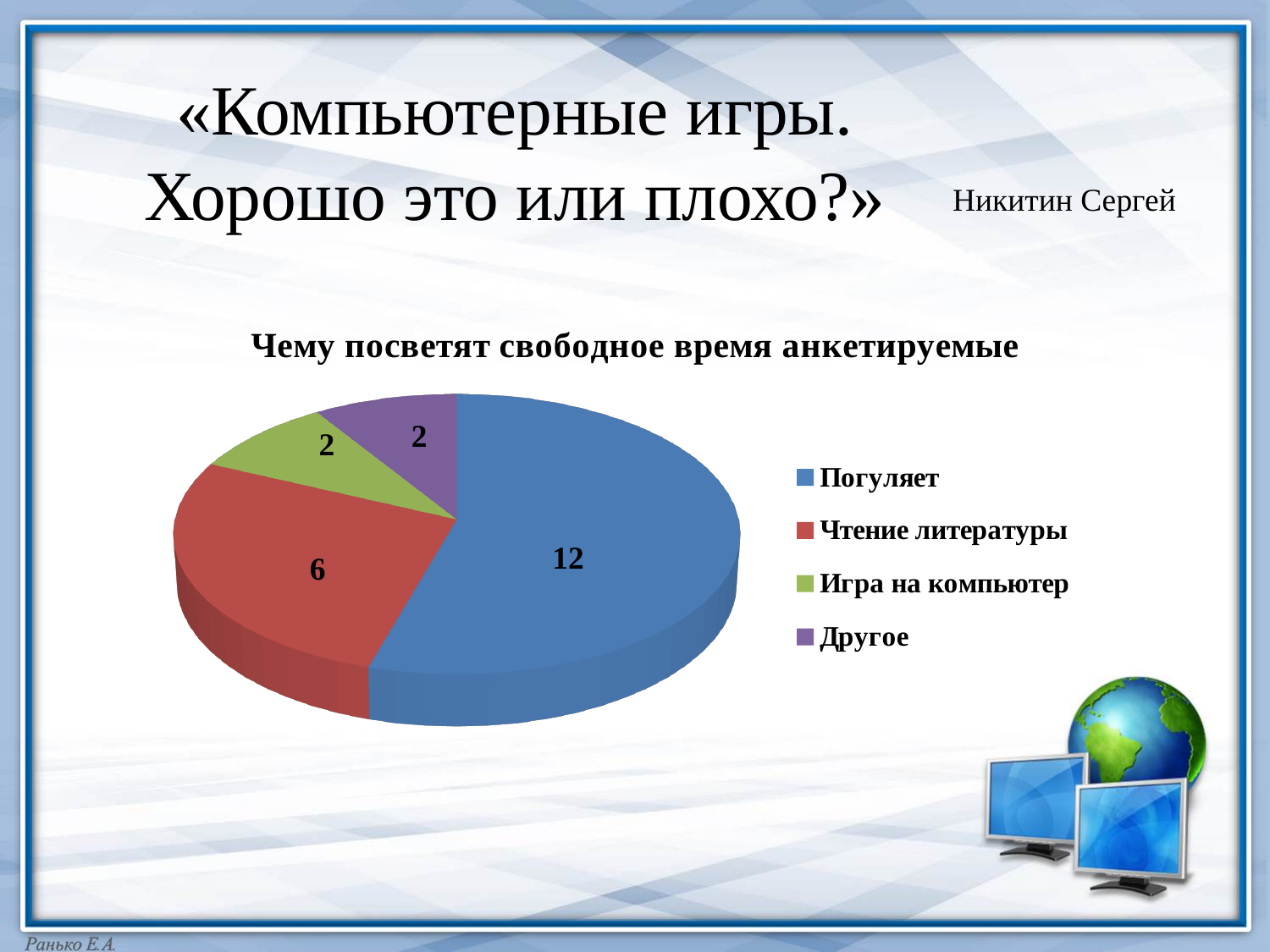
What colour is the slice for Чтение литературы? Red What is the difference between the values for Погуляет and Чтение литературы? 6 What is the title of the chart? Чему посветят свободное время анкетируемые Which is larger, the value for Чтение литературы or the value for Игра на компьютер? Чтение литературы What is the value for Игра на компьютер in the pie chart? 2 What type of chart is shown on the slide? Pie chart What is the value for Погуляет in the pie chart? 12 What is the total of all the values shown in the pie chart? 22 How many categories does the pie chart show? 4 What is the value for Чтение литературы in the pie chart? 6 What is the value for Другое in the pie chart? 2 Which category has the largest slice in the pie chart? Погуляет